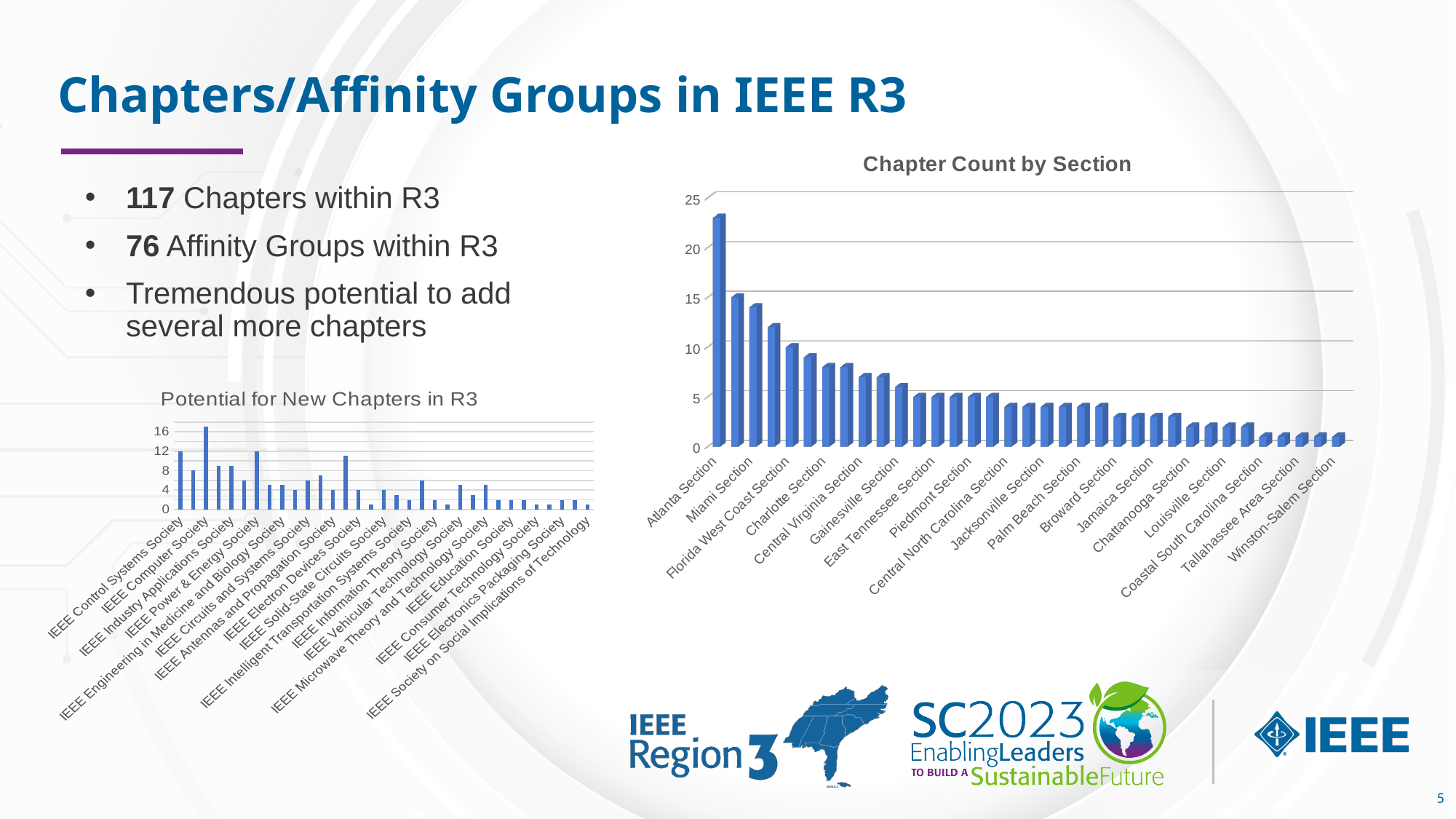
In the 'Chapter Count by Section' chart, is the value for Winston-Salem Section greater or less than 5? less What is the title of the chart on the left side of the slide? Potential for New Chapters in R3 What kind of chart is 'Potential for New Chapters in R3'? bar chart In the 'Potential for New Chapters in R3' chart, which society has the highest value? IEEE Computer Society In the 'Potential for New Chapters in R3' chart, which is larger, IEEE Computer Society or IEEE Education Society? IEEE Computer Society What is the title of the chart on the right side of the slide? Chapter Count by Section In the 'Chapter Count by Section' chart, do the values rise or fall moving from left to right along the x axis? fall In the 'Chapter Count by Section' chart, which has more chapters, Atlanta Section or Miami Section? Atlanta Section In the 'Chapter Count by Section' chart, is the value for Atlanta Section greater or less than 20? greater In the 'Chapter Count by Section' chart, which section has the highest chapter count? Atlanta Section In the 'Potential for New Chapters in R3' chart, is the value for IEEE Computer Society greater or less than 12? greater What kind of chart is 'Chapter Count by Section'? bar chart